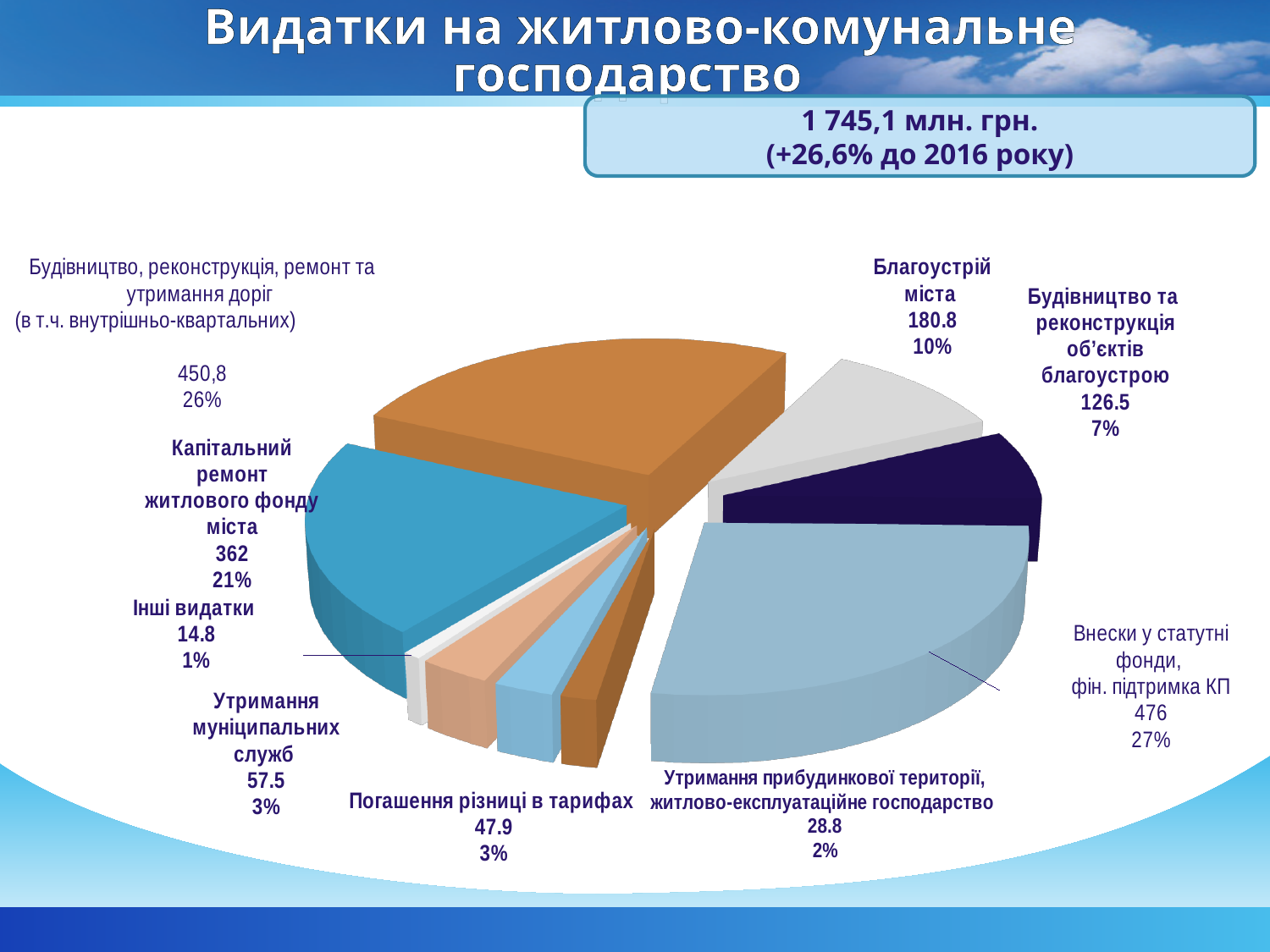
Which category has the smallest value? Інші видатки What is the difference between the values for "Утримання муніципальних служб" and "Утримання прибудинкової території, житлово-експлуатаційне господарство"? 28.7 What share of the pie does "Будівництво, реконструкція, ремонт та утримання доріг" represent? 26% What is the value for "Благоустрій міста"? 180.8 What is the value for "Капітальний ремонт житлового фонду міста"? 362 What share of the pie does "Будівництво та реконструкція об'єктів благоустрою" represent? 7% Which is larger: the value for "Благоустрій міста" or the value for "Будівництво та реконструкція об'єктів благоустрою"? Благоустрій міста Which category has the largest value? Внески у статутні фонди, фін. підтримка КП What is the value for "Погашення різниці в тарифах"? 47.9 How many categories (slices) does the pie chart show? 9 What kind of chart is shown on the slide? pie chart What is the title of the slide containing the chart? Видатки на житлово-комунальне господарство